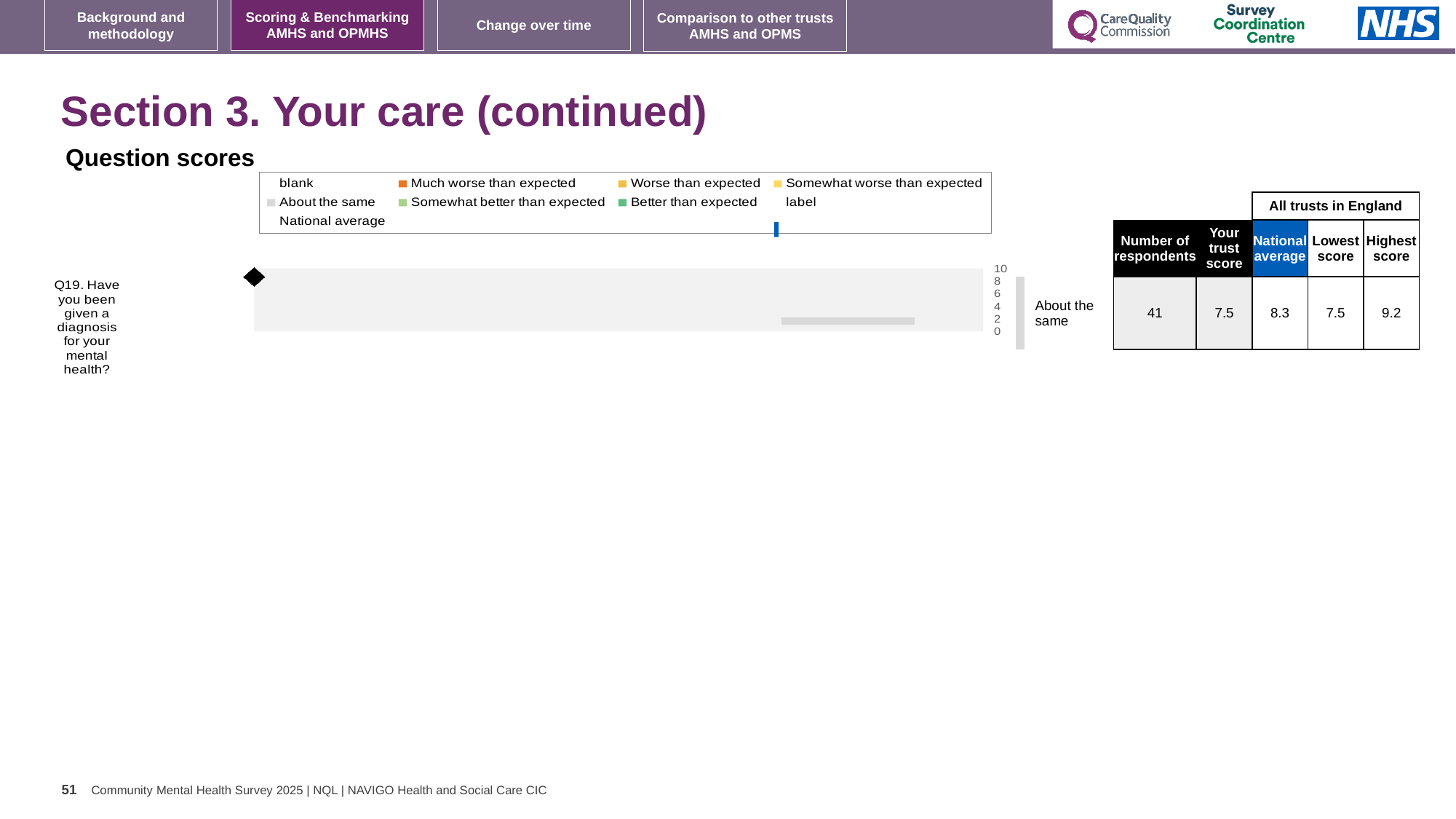
What is the highest score among all trusts in England for Q19? 9.2 What is the lowest score among all trusts in England for Q19? 7.5 How many respondents answered Q19? 41 How many questions are plotted on the chart? 1 What is the trust score for Q19 (Have you been given a diagnosis for your mental health?)? 7.5 Is the trust score for Q19 greater or less than 8? less What is the difference between the national average and the trust score for Q19? 0.8 What benchmark category is the Q19 bar labelled with? About the same Which is larger for Q19, the trust score or the national average? national average What is the difference between the highest and lowest trust scores for Q19? 1.7 What kind of chart is used to show the Q19 question score? bar chart What is the national average score for Q19? 8.3